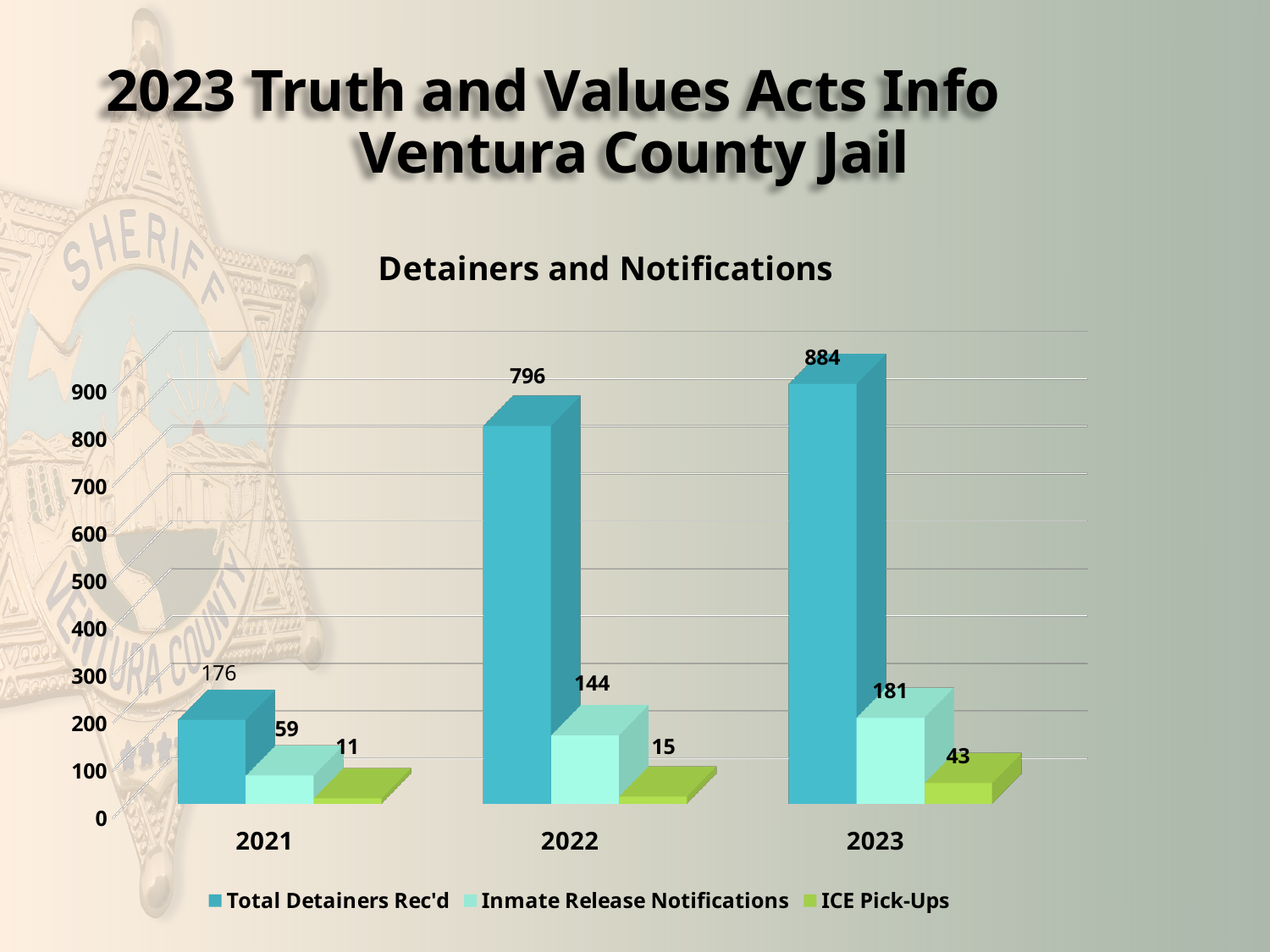
Is the value for Total Detainers Rec'd in 2021 greater or less than 200? less Which is larger: Inmate Release Notifications in 2022 or in 2023? 2023 Which year has the lowest value for ICE Pick-Ups? 2021 How many years are shown on the x axis? 3 What is the value of Total Detainers Rec'd for 2022? 796 What kind of chart is shown on the slide? bar chart What is the value of ICE Pick-Ups for 2023? 43 How many series does the legend list? 3 Which year has the highest value for Total Detainers Rec'd? 2023 What is the value of Inmate Release Notifications for 2021? 59 What is the difference between Total Detainers Rec'd in 2023 and 2022? 88 What is the title of the chart? Detainers and Notifications